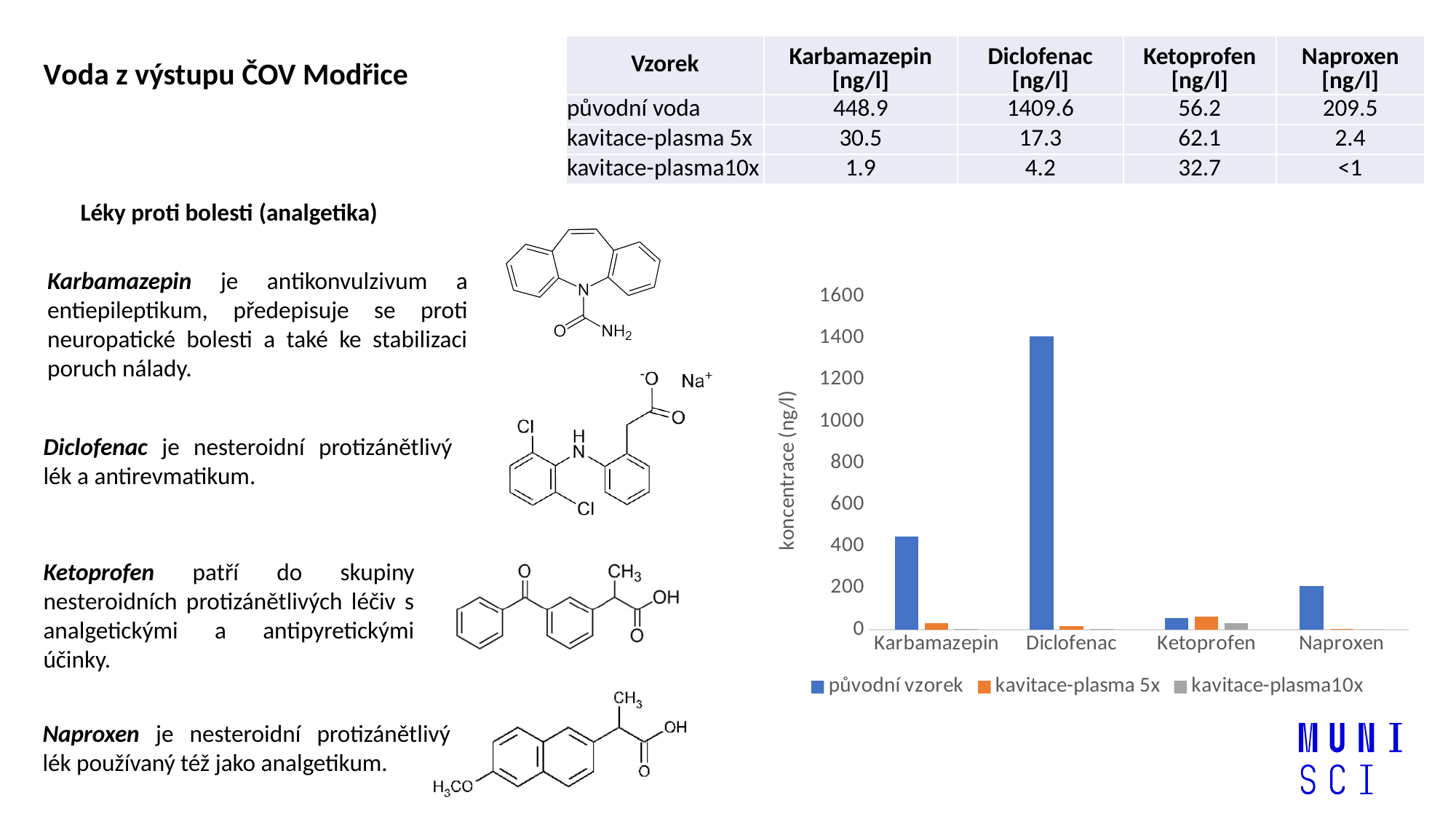
Which category has the highest bar for the původní vzorek series? Diclofenac According to the table, what is the Diclofenac concentration in the původní voda sample? 1409.6 How many series does the chart legend list? 3 What is the label on the y axis of the chart? koncentrace (ng/l) Is the původní vzorek value for Karbamazepin greater or less than 600? less Is the původní vzorek value for Diclofenac greater or less than 1200? greater What colour represents the kavitace-plasma 5x series in the chart? orange According to the table, what is the difference between the Karbamazepin concentration in původní voda and in kavitace-plasma 5x? 418.4 What kind of chart is shown on the slide? bar chart How many categories are shown on the x axis of the chart? 4 For the původní vzorek series, which is larger: Karbamazepin or Naproxen? Karbamazepin Which category has the lowest bar for the původní vzorek series? Ketoprofen